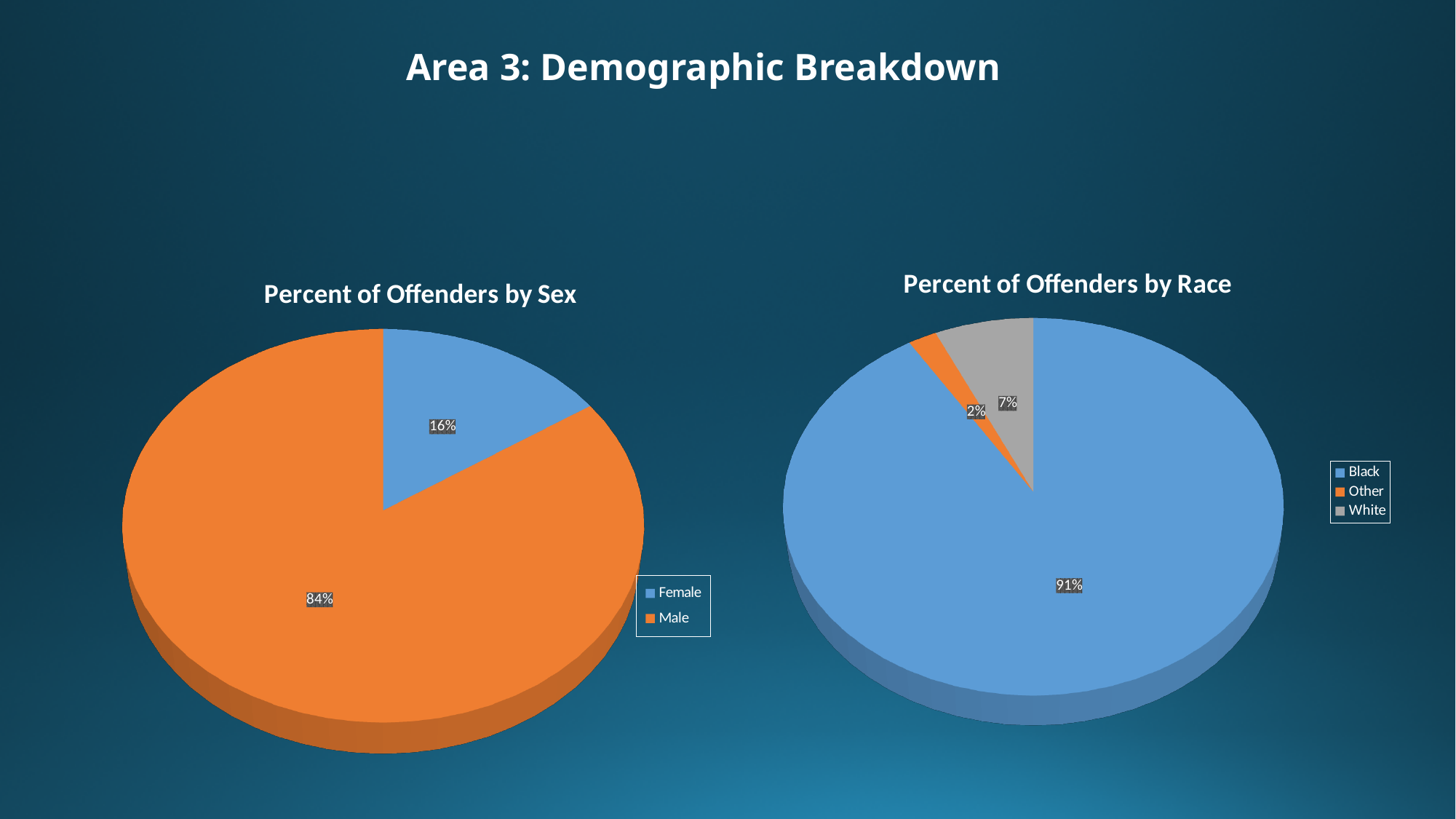
In the 'Percent of Offenders by Sex' chart, what is the difference in percentage points between Male and Female? 68 In the 'Percent of Offenders by Race' chart, which category has the largest share? Black In the 'Percent of Offenders by Race' chart, which category has the smallest share? Other In the 'Percent of Offenders by Race' chart, which is larger, the White share or the Other share? White What colour represents Male in the 'Percent of Offenders by Sex' chart? Orange How many categories does the legend of the 'Percent of Offenders by Race' chart list? 3 What type of chart is 'Percent of Offenders by Sex'? Pie chart In the 'Percent of Offenders by Sex' chart, what percentage of offenders are Female? 16% In the 'Percent of Offenders by Race' chart, what percentage of offenders are in the Other category? 2% In the 'Percent of Offenders by Sex' chart, what percentage of offenders are Male? 84% In the 'Percent of Offenders by Race' chart, what percentage of offenders are White? 7% In the 'Percent of Offenders by Race' chart, what percentage of offenders are Black? 91%